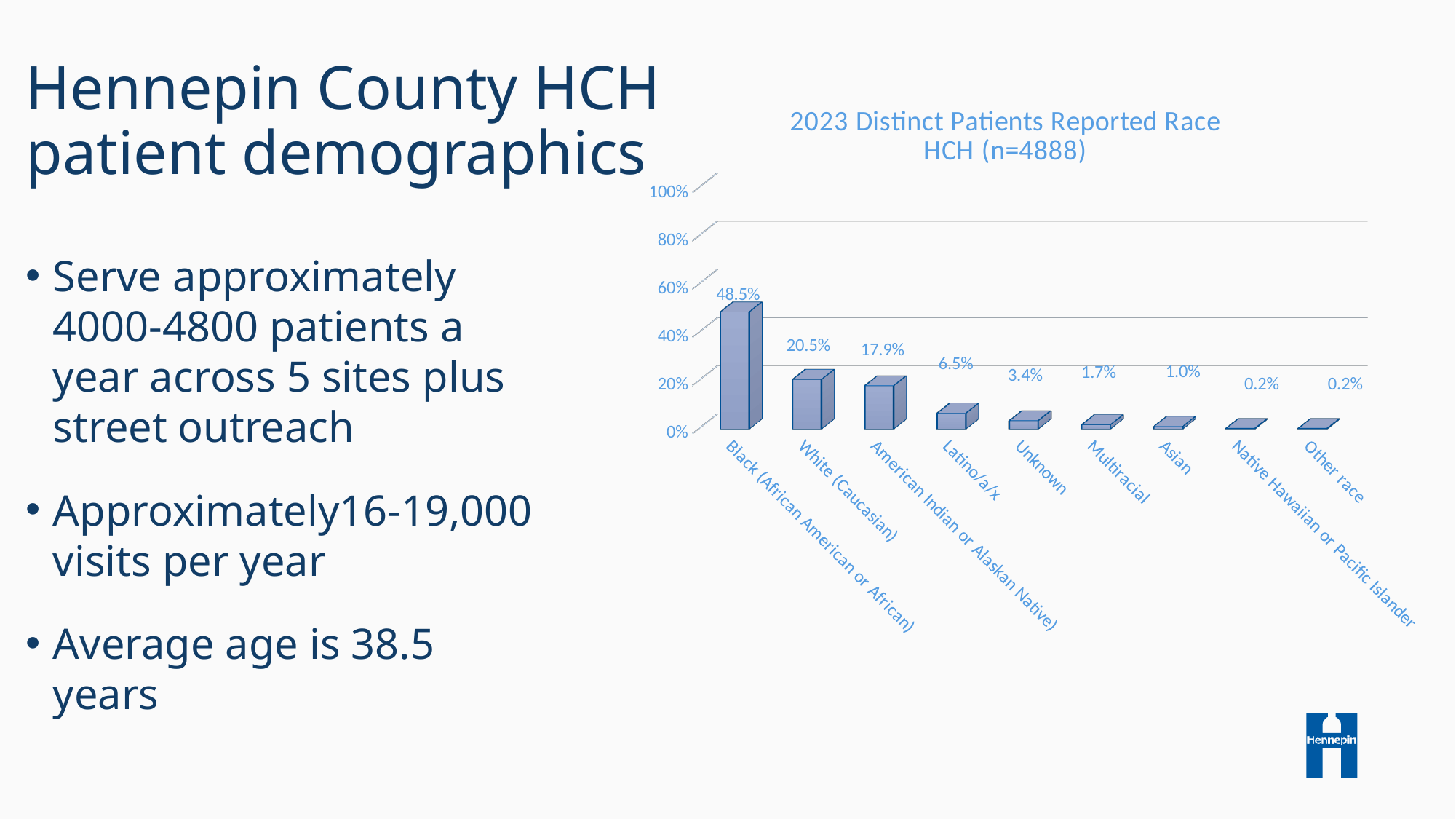
Which race category has the highest percentage? Black (African American or African) Which is larger, the value for Latino/a/x or the value for Multiracial? Latino/a/x Do the values rise or fall from left to right along the x axis? Fall What percentage of patients reported their race as White (Caucasian)? 20.5% What is the title of the chart? 2023 Distinct Patients Reported Race HCH (n=4888) What kind of chart is shown on the slide? Bar chart What is the value for Unknown? 3.4% What is the value for American Indian or Alaskan Native? 17.9% What is the difference between the White (Caucasian) and American Indian or Alaskan Native percentages? 2.6% What percentage of patients reported their race as Black (African American or African)? 48.5% Is the value for Black (African American or African) greater or less than 40%? greater How many race categories are shown on the chart? 9